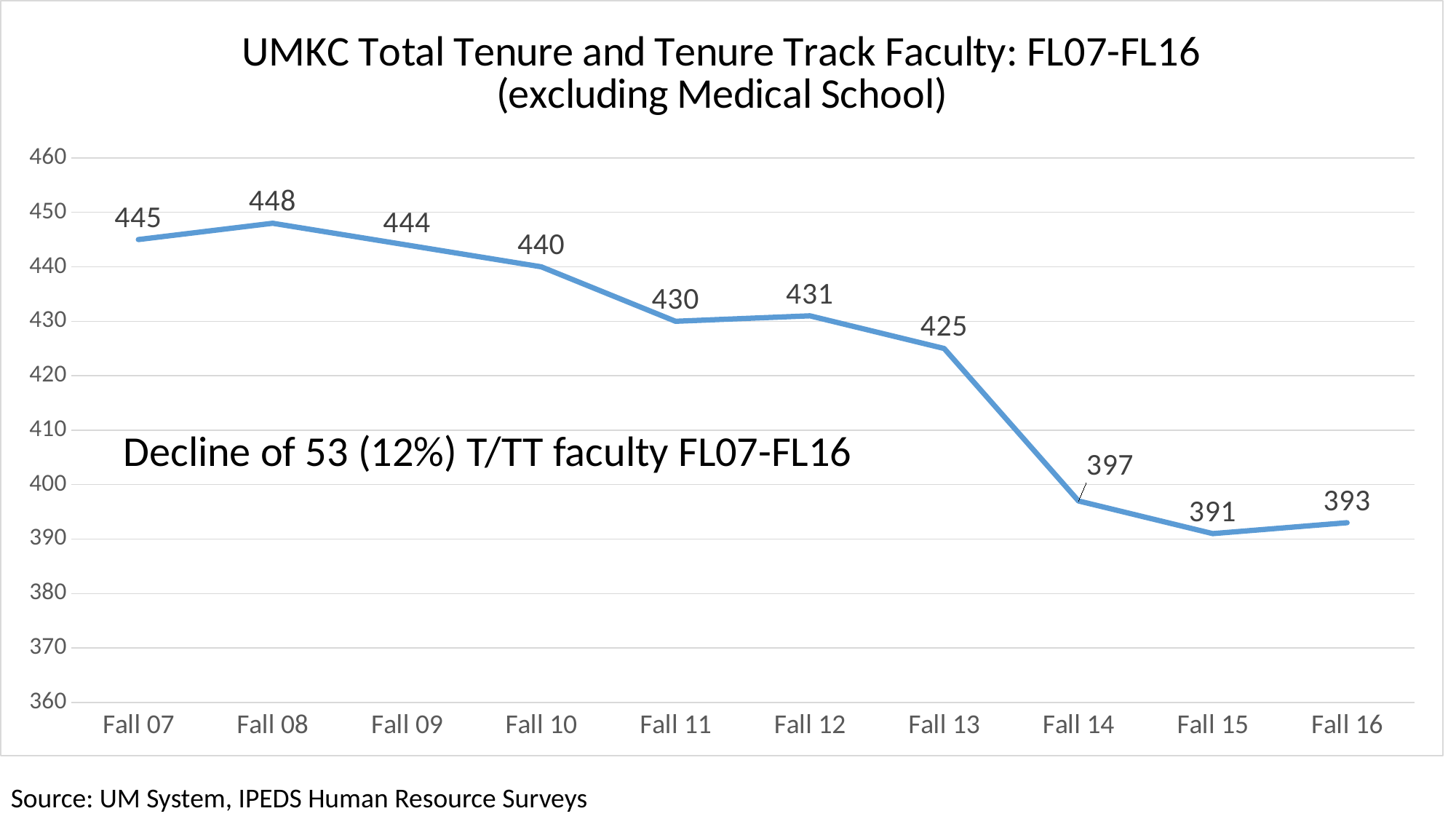
How many data points are plotted on the chart? 10 What is the title of the chart? UMKC Total Tenure and Tenure Track Faculty: FL07-FL16 (excluding Medical School) Do the values generally rise or fall from Fall 07 to Fall 16? Fall What kind of chart is this? Line chart What is the value for Fall 16? 393 What is the value for Fall 07? 445 What is the difference between the values for Fall 13 and Fall 14? 28 What is the difference between the values for Fall 07 and Fall 16? 52 What is the value for Fall 14? 397 Which year has the lowest value? Fall 15 Which year has the highest value? Fall 08 Which is larger, the value for Fall 11 or the value for Fall 12? Fall 12